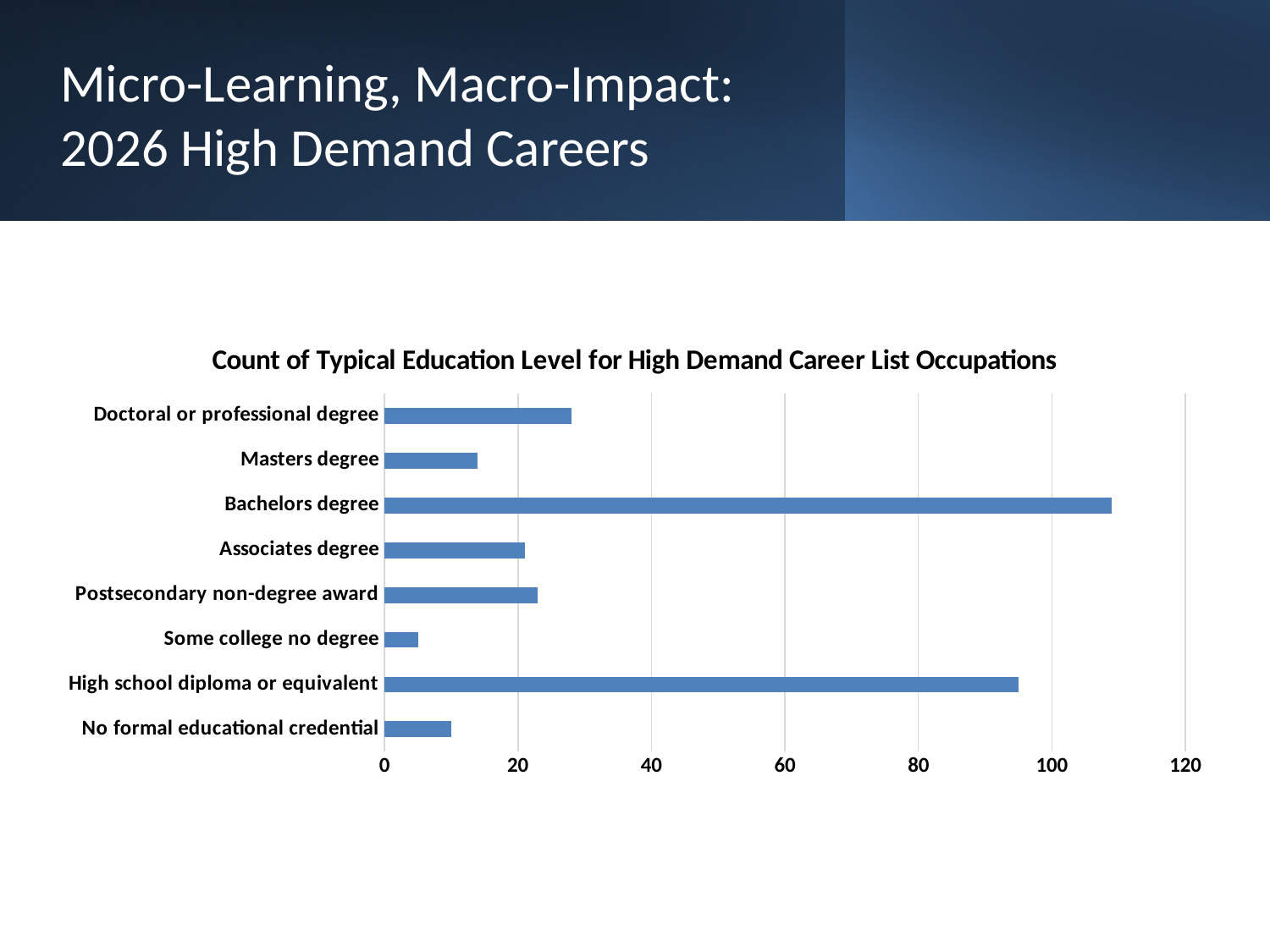
What is the title of the chart? Count of Typical Education Level for High Demand Career List Occupations Which has a larger count, Bachelors degree or High school diploma or equivalent? Bachelors degree Is the value for Doctoral or professional degree greater or less than 20? greater Which education level has the lowest count? Some college no degree Is the value for No formal educational credential greater or less than 20? less Is the value for Bachelors degree greater or less than 100? greater How many education level categories are plotted in the chart? 8 Which education level has the highest count? Bachelors degree What kind of chart is shown on the slide? bar chart Which has a larger count, Doctoral or professional degree or Masters degree? Doctoral or professional degree